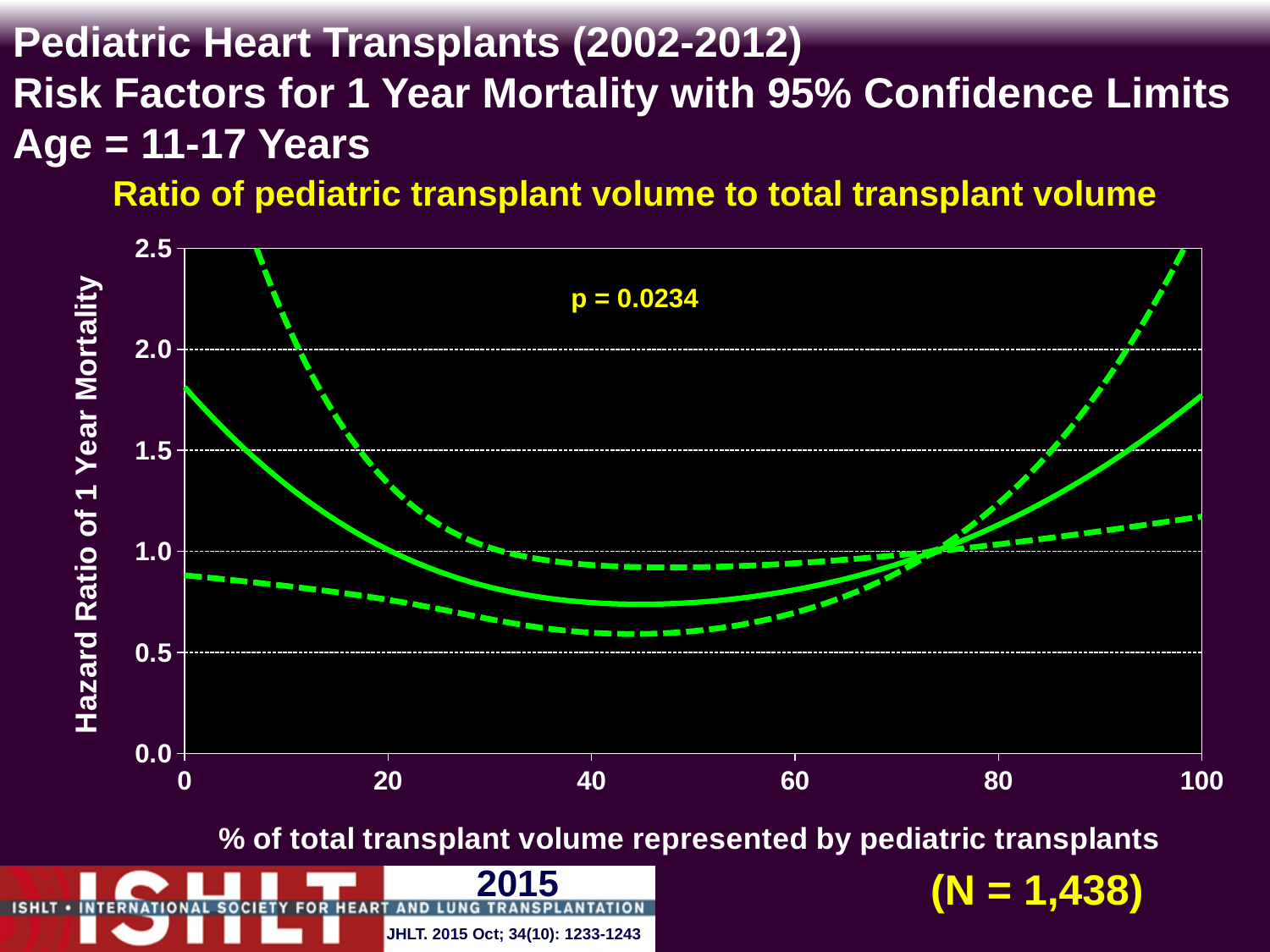
Is the hazard ratio on the solid line at 0% pediatric transplant volume greater or less than 1.5? greater Does the solid hazard ratio line rise or fall as the x axis goes from 0 to 40? fall What kind of chart is shown on the slide? line chart What sample size (N) is shown on the slide? N = 1,438 How many curves are plotted on the chart? 3 Does the solid hazard ratio line rise or fall as the x axis goes from 60 to 100? rise What p-value is printed on the chart? p = 0.0234 Is the lower dashed confidence limit at 40% pediatric transplant volume greater or less than 1.0? less Is the hazard ratio on the solid line at 40% pediatric transplant volume greater or less than 1.0? less On the solid line, is the hazard ratio larger at 0% or at 40% pediatric transplant volume? 0%